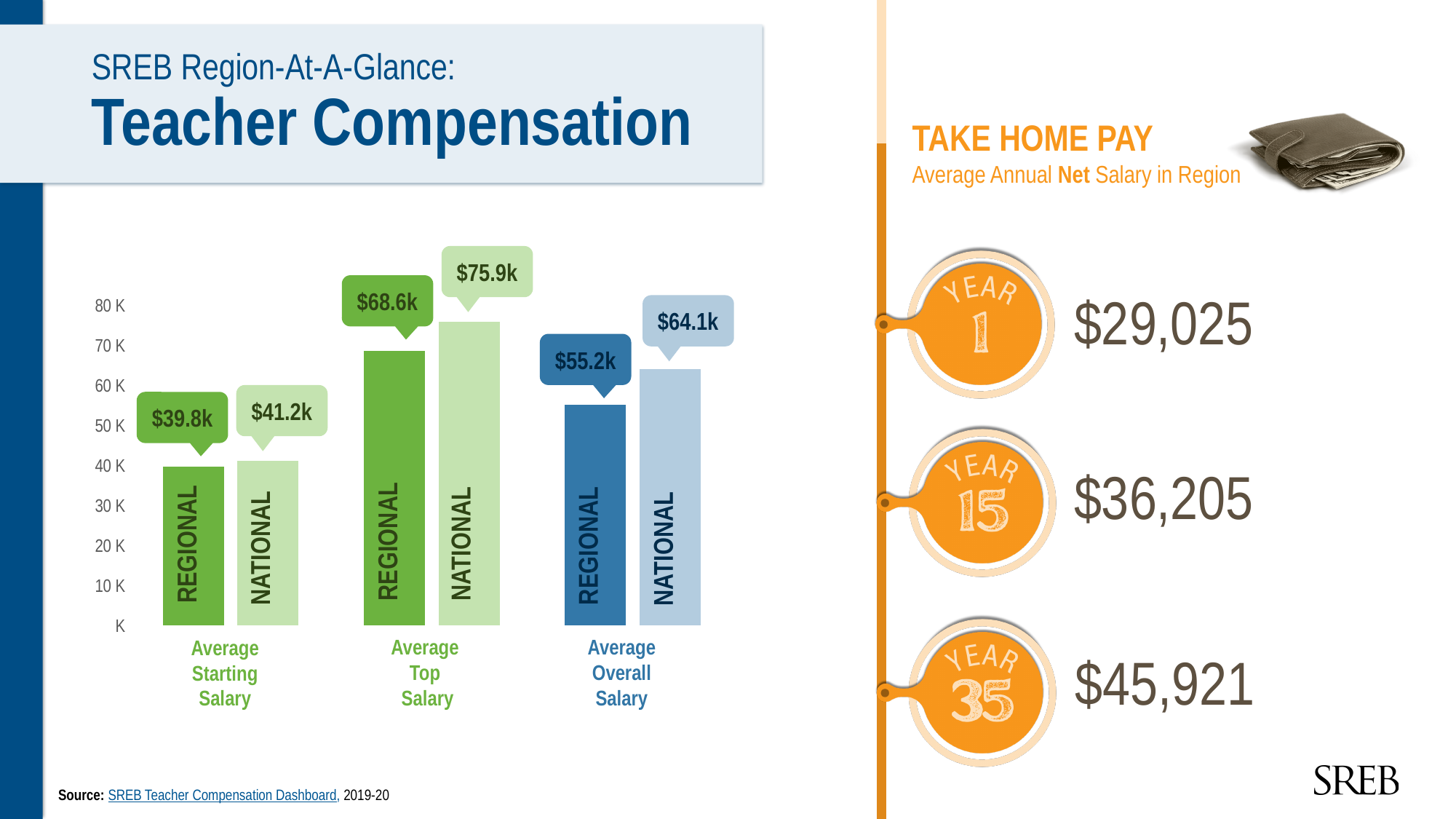
What is the National value for Average Overall Salary? $64.1k What kind of chart is used to show the salary comparison? Bar chart What is the difference between the National and Regional values for Average Overall Salary? $8.9k What is the difference between the National and Regional values for Average Top Salary? $7.3k How many salary categories are shown on the x axis of the chart? 3 Which bar in the chart has the lowest value? Regional Average Starting Salary ($39.8k) For Average Starting Salary, which is larger: the Regional or the National value? National Is the Regional value for Average Top Salary greater or less than 60 K? greater What is the Regional value for Average Overall Salary? $55.2k What is the Regional value for Average Starting Salary? $39.8k Which bar in the chart has the highest value? National Average Top Salary ($75.9k) What is the National value for Average Top Salary? $75.9k